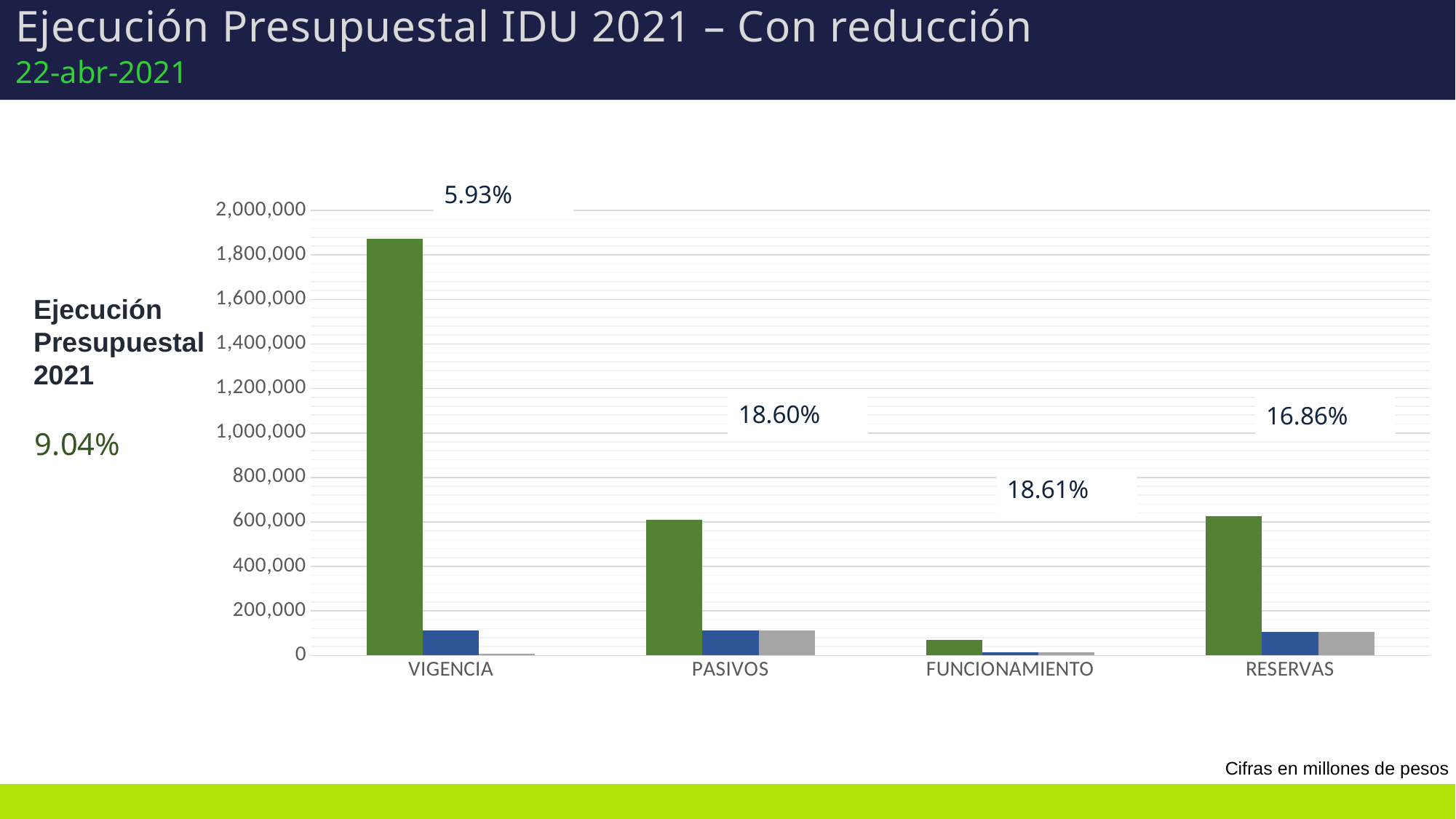
Which category has the shortest green bar? FUNCIONAMIENTO Is the green bar for VIGENCIA greater or less than 1,800,000? greater What percentage label is shown above the RESERVAS group? 16.86% What percentage label is shown above the FUNCIONAMIENTO group? 18.61% What kind of chart is shown on the slide? bar chart What is the overall Ejecución Presupuestal 2021 percentage shown to the left of the chart? 9.04% What percentage label is shown above the VIGENCIA group? 5.93% Is the green bar for FUNCIONAMIENTO greater or less than 200,000? less Which has a taller green bar, VIGENCIA or PASIVOS? VIGENCIA What percentage label is shown above the PASIVOS group? 18.60% How many categories are shown on the x axis of the chart? 4 Which category has the tallest green bar? VIGENCIA